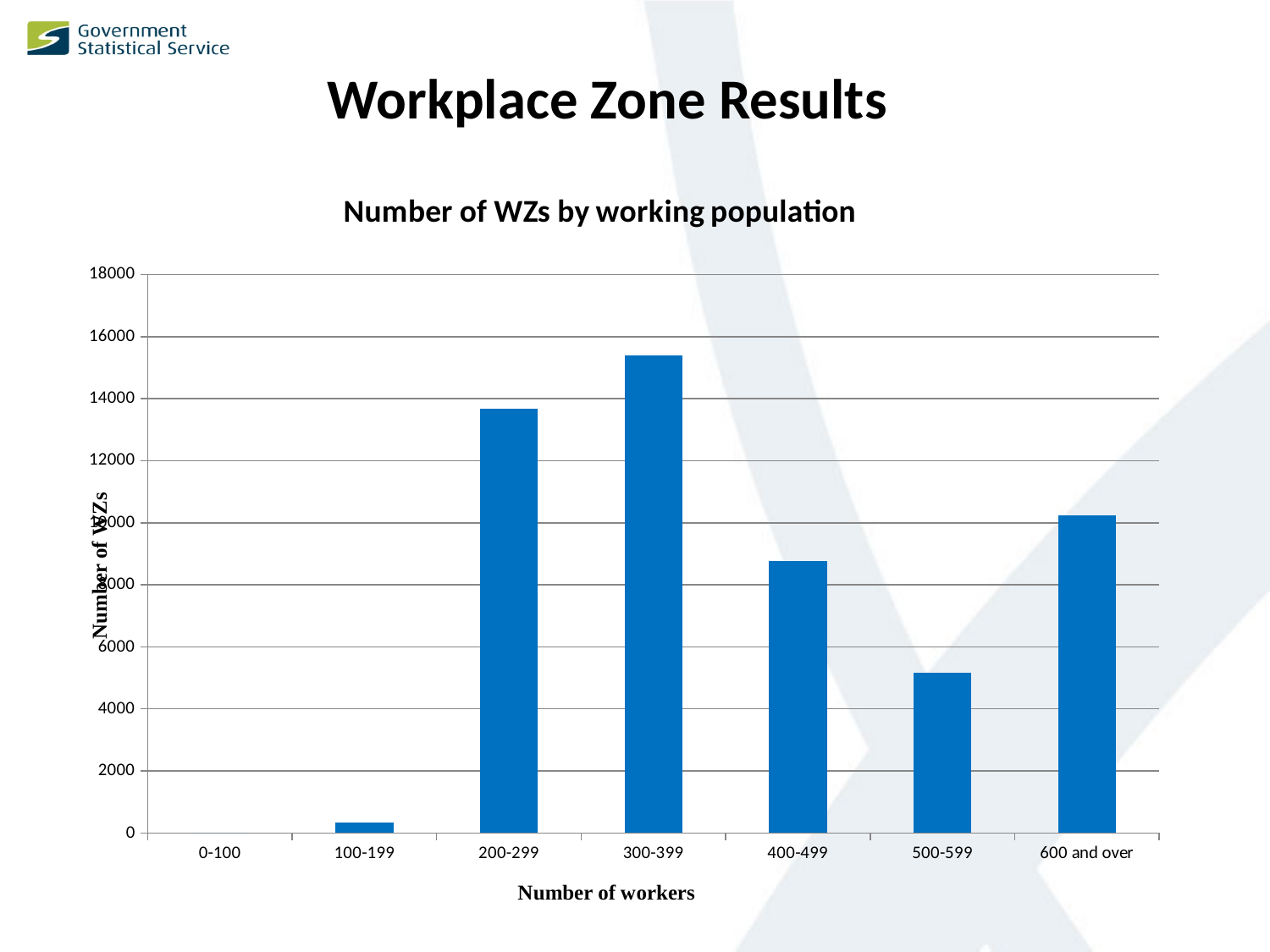
How many categories are shown on the x axis of the chart? 7 What kind of chart is shown on the slide? bar chart Which has more WZs, the 200-299 category or the 400-499 category? 200-299 Which category has the lowest number of WZs? 0-100 Is the value for 300-399 greater or less than 14000? greater Which category has the highest number of WZs? 300-399 What is the title of the chart? Number of WZs by working population Is the value for 100-199 greater or less than 2000? less What is the title of the x axis of the chart? Number of workers Is the value for 500-599 greater or less than 6000? less Which has more WZs, the 600 and over category or the 500-599 category? 600 and over